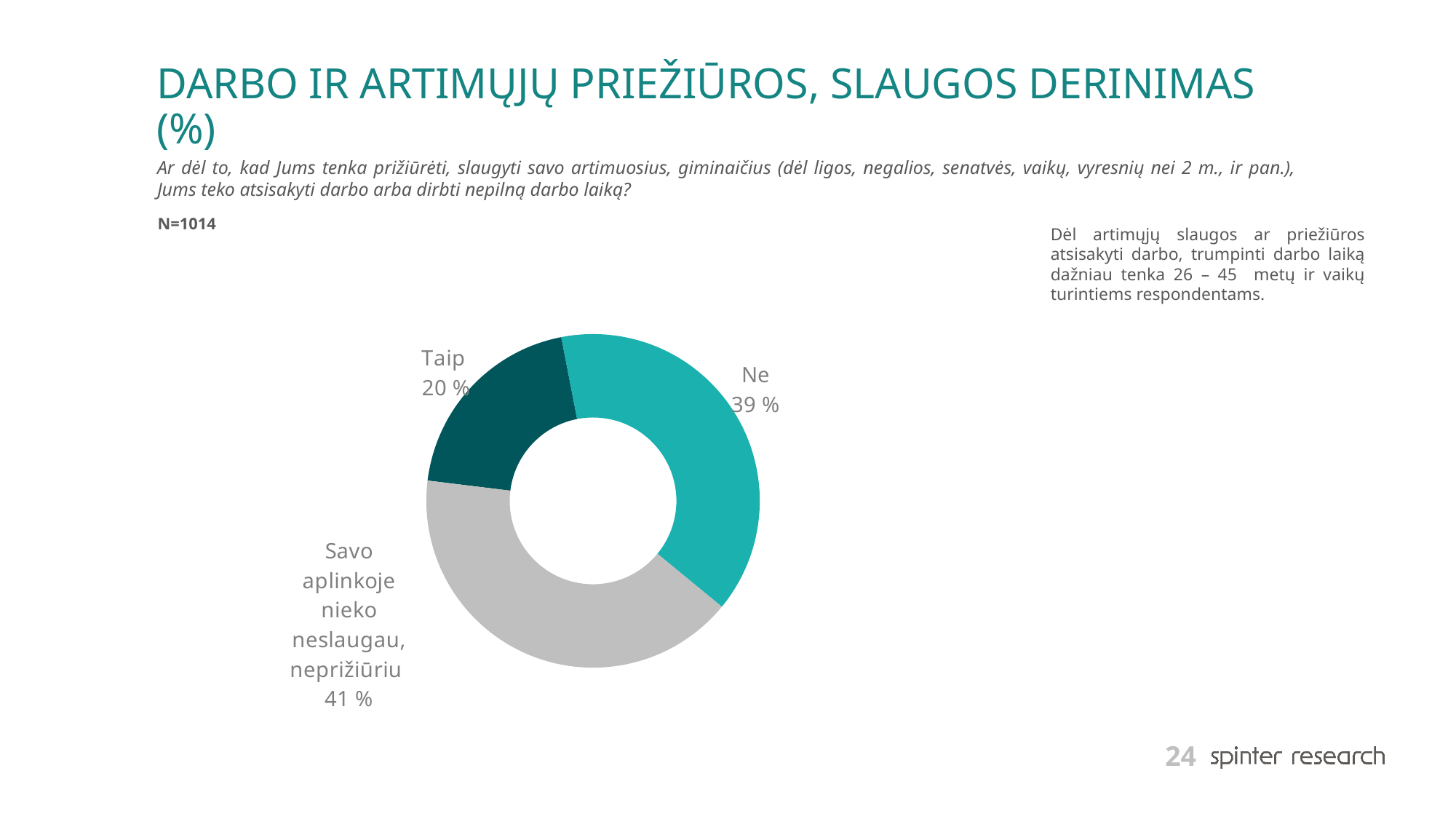
Which category has the largest share of the chart? Savo aplinkoje nieko neslaugau, neprižiūriu Which category has the smallest share of the chart? Taip What percentage of respondents answered "Taip"? 20 % How many categories are shown in the chart? 3 Which is larger, the share for "Ne" or the share for "Taip"? Ne What is the difference in percentage points between "Ne" and "Taip"? 19 What percentage of respondents answered "Savo aplinkoje nieko neslaugau, neprižiūriu"? 41 % What kind of chart is shown on the slide? Pie (donut) chart What colour is the "Savo aplinkoje nieko neslaugau, neprižiūriu" slice? Grey What is the difference in percentage points between "Savo aplinkoje nieko neslaugau, neprižiūriu" and "Taip"? 21 What percentage of respondents answered "Ne"? 39 % What is the sample size (N) stated on the slide? N=1014